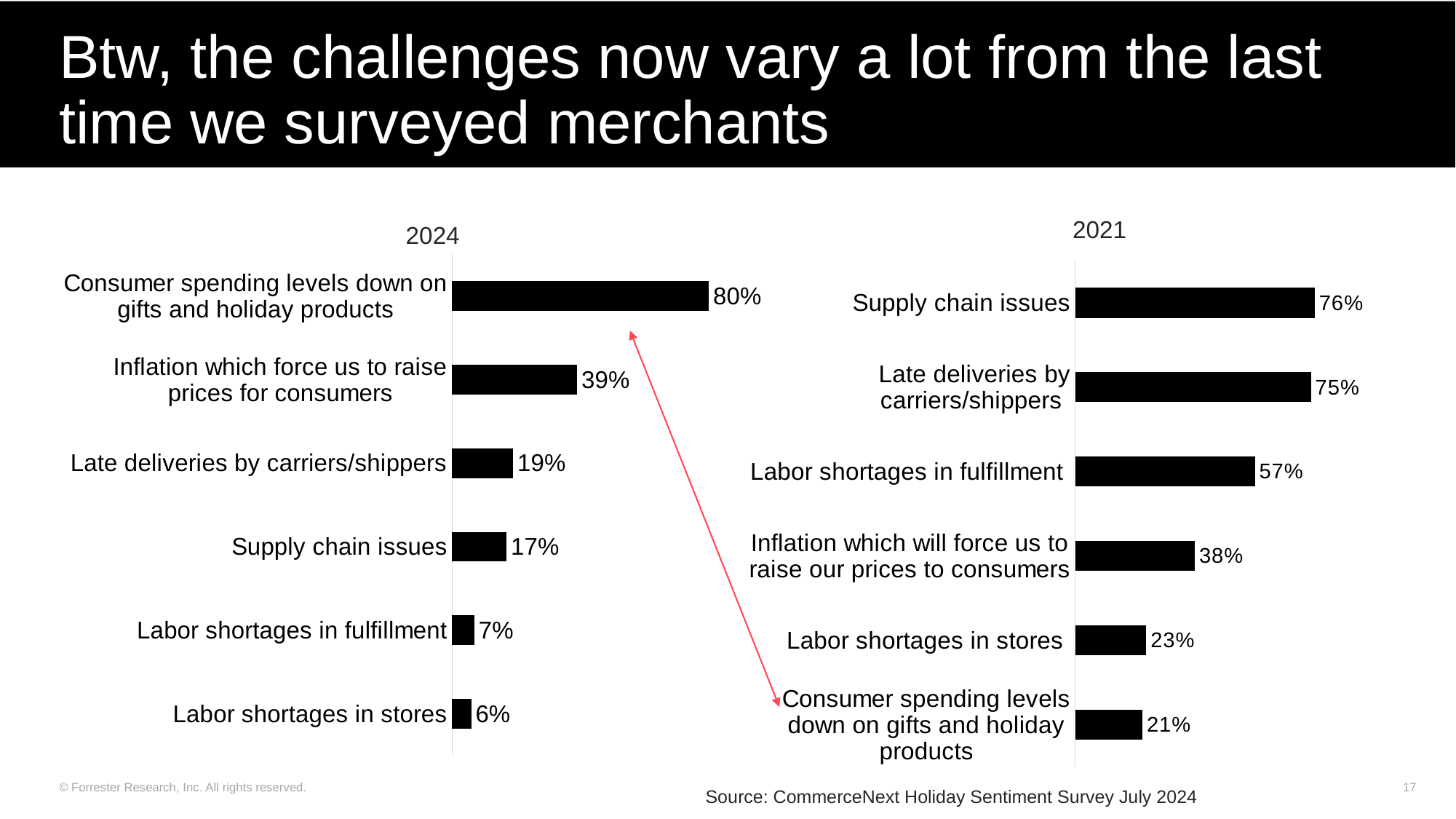
In the 2021 chart, which category has the lowest value? Consumer spending levels down on gifts and holiday products How many categories does the 2024 chart show? 6 In the 2024 chart, what is the value for Supply chain issues? 17% What is the title of the chart on the left side of the slide? 2024 In the 2021 chart, what is the value for Labor shortages in fulfillment? 57% In the 2021 chart, which category has the highest value? Supply chain issues In the 2024 chart, what is the difference between Consumer spending levels down on gifts and holiday products and Inflation which force us to raise prices for consumers? 41% In the 2024 chart, which category has the lowest value? Labor shortages in stores In the 2024 chart, which is larger: Late deliveries by carriers/shippers or Labor shortages in fulfillment? Late deliveries by carriers/shippers In the 2021 chart, what is the difference between Supply chain issues and Late deliveries by carriers/shippers? 1% In the 2024 chart, what is the value for Consumer spending levels down on gifts and holiday products? 80% What kind of chart is the 2021 chart? Bar chart